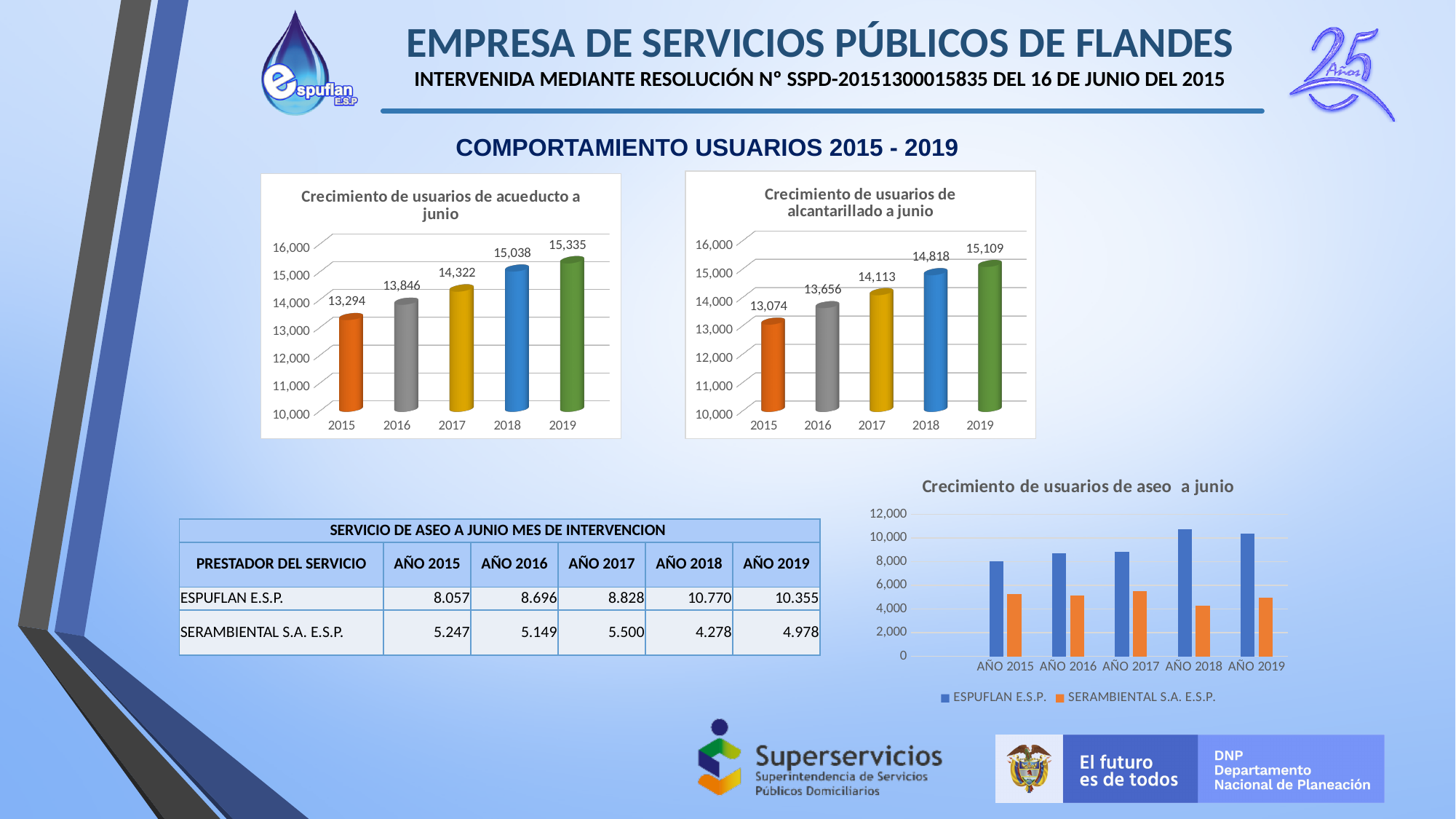
In the 'Crecimiento de usuarios de aseo a junio' chart, is the value for ESPUFLAN E.S.P. in AÑO 2018 greater or less than 10,000? greater In the 'Crecimiento de usuarios de alcantarillado a junio' chart, how many years are plotted? 5 What kind of chart is 'Crecimiento de usuarios de aseo a junio'? bar chart In the 'Crecimiento de usuarios de acueducto a junio' chart, what is the difference between the 2019 and 2015 values? 2,041 In the 'Crecimiento de usuarios de aseo a junio' chart, how many series does the legend list? 2 In the 'Crecimiento de usuarios de acueducto a junio' chart, do the values rise or fall from 2015 to 2019? rise In the 'Crecimiento de usuarios de alcantarillado a junio' chart, what is the difference between the 2018 and 2017 values? 705 In the 'Crecimiento de usuarios de aseo a junio' chart, which series has the larger value in AÑO 2019, ESPUFLAN E.S.P. or SERAMBIENTAL S.A. E.S.P.? ESPUFLAN E.S.P. In the 'Crecimiento de usuarios de acueducto a junio' chart, which year has the highest value? 2019 In the 'Crecimiento de usuarios de alcantarillado a junio' chart, what is the value for 2016? 13,656 In the 'Crecimiento de usuarios de alcantarillado a junio' chart, which year has the lowest value? 2015 In the 'Crecimiento de usuarios de acueducto a junio' chart, what is the value for 2017? 14,322